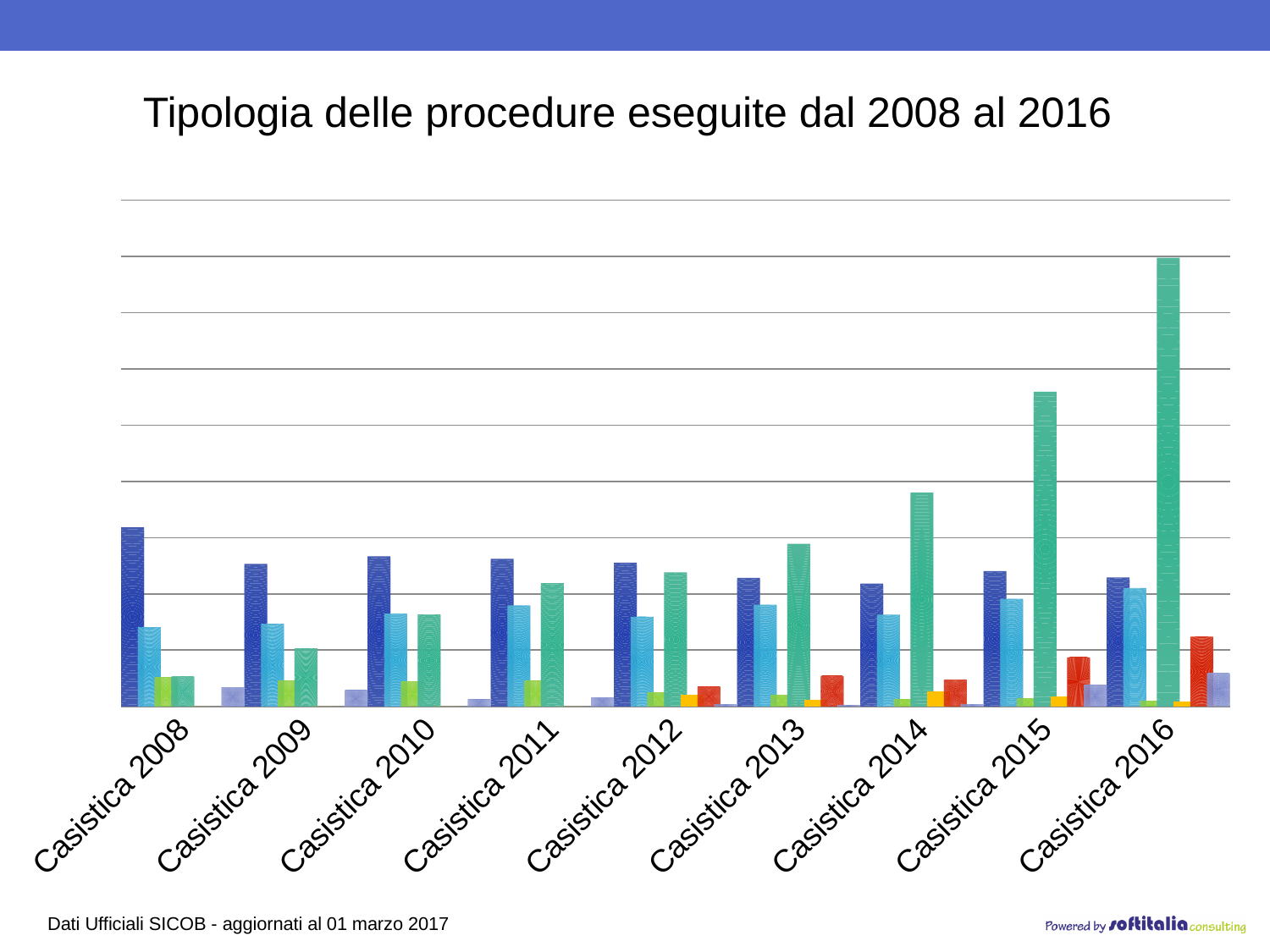
What source note is printed at the bottom left of the slide? Dati Ufficiali SICOB - aggiornati al 01 marzo 2017 What kind of chart is shown on the slide? bar chart How many categories (years) are shown on the x axis of the chart? 9 For Casistica 2016, which is taller: the light blue bar or the red bar? the light blue bar Is the green bar taller for Casistica 2015 or for Casistica 2014? Casistica 2015 Does the green bar rise or fall from Casistica 2008 to Casistica 2016? rise For Casistica 2008, which is taller: the dark blue bar or the green bar? the dark blue bar Which category contains the tallest bar in the chart? Casistica 2016 Which category has the shortest green bar? Casistica 2008 What is the title of the chart on the slide? Tipologia delle procedure eseguite dal 2008 al 2016